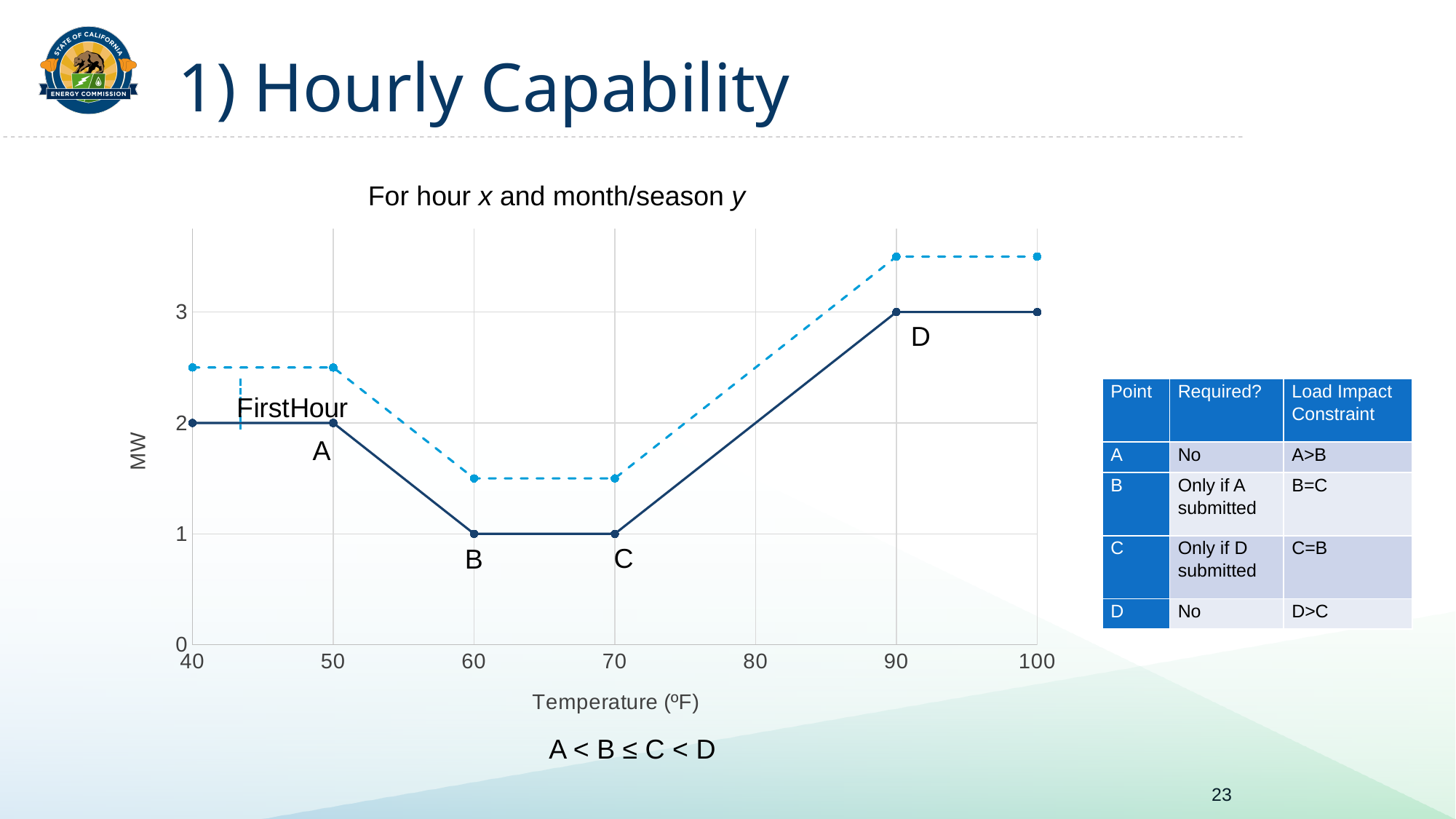
Does the solid line rise or fall between 70 °F and 90 °F? rise How many lines are plotted on the chart? 2 What is the MW value of the solid line at point A (50 °F)? 2 Which labeled point (A, B, C or D) has the highest MW value on the solid line? D Is the dashed line's value at 60 °F greater or less than 2 MW? less What is the label of the x axis of the chart? Temperature (ºF) What kind of chart is shown on the slide? line chart Which is larger on the solid line, the value at point A or the value at point D? D Is the dashed line's value at 90 °F greater or less than 3 MW? greater What is the difference in MW between point D and point A on the solid line? 1 What is the MW value of the solid line at point D (90 °F)? 3 What is the MW value of the solid line at point B (60 °F)? 1